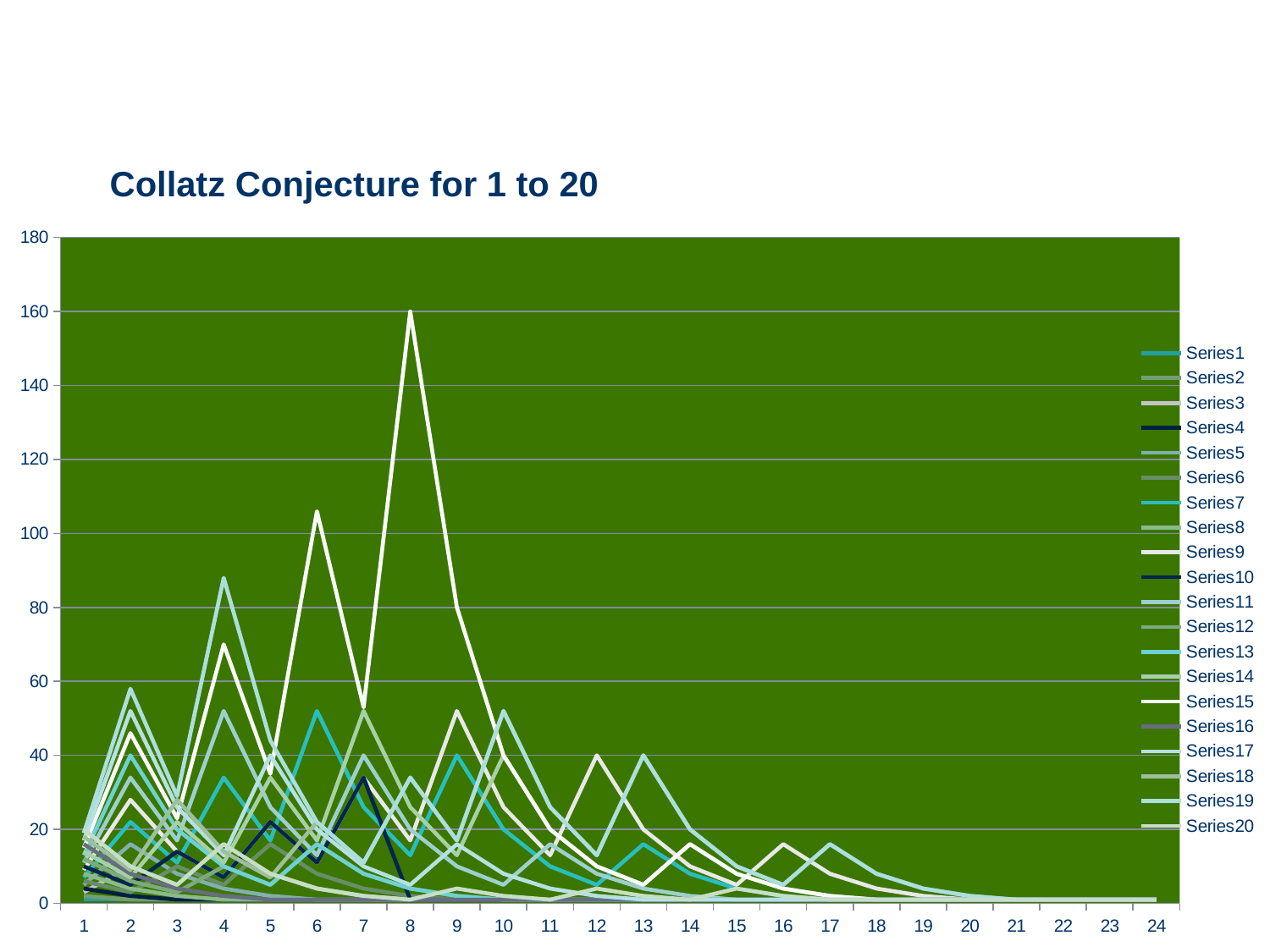
What is the title of the chart? Collatz Conjecture for 1 to 20 What is the highest value reached by any line on the chart? 160 What kind of chart is shown on the slide? line chart Do the lines generally rise or fall as the x axis moves toward 24? fall Are the values of the lines at x-axis position 24 greater or less than 20? less How many points are labelled along the x axis? 24 Is the tallest peak at x-axis position 6 greater or less than 120? less Is the highest peak on the chart greater or less than 140? greater What is the highest value shown on the y axis? 180 How many series does the legend list? 20 At which x-axis position does the highest peak of any line occur? 8